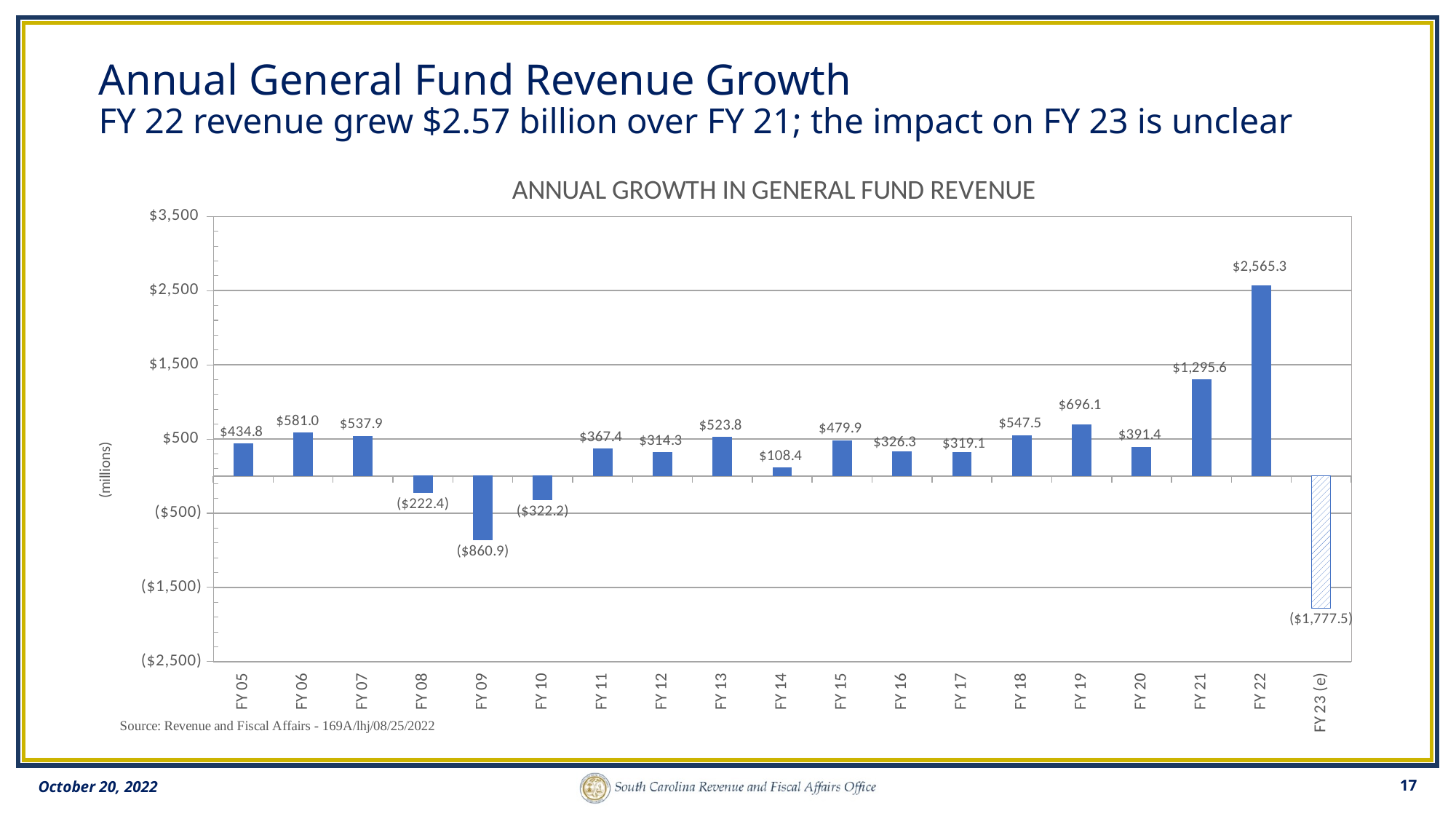
What kind of chart is shown on the slide? Bar chart What is the estimated value shown for FY 23 (e)? ($1,777.5) What is the value shown for FY 14? $108.4 Which fiscal year has the highest annual growth in general fund revenue? FY 22 What unit is indicated on the vertical axis label? (millions) Which is larger, the value for FY 06 or the value for FY 07? FY 06 What is the title of the chart? ANNUAL GROWTH IN GENERAL FUND REVENUE Which fiscal year has the lowest value on the chart? FY 23 (e) What is the difference between the FY 22 value and the FY 21 value? $1,269.7 What is the value shown for FY 09? ($860.9) What is the annual growth in general fund revenue for FY 22? $2,565.3 How many fiscal years are shown on the x axis? 19